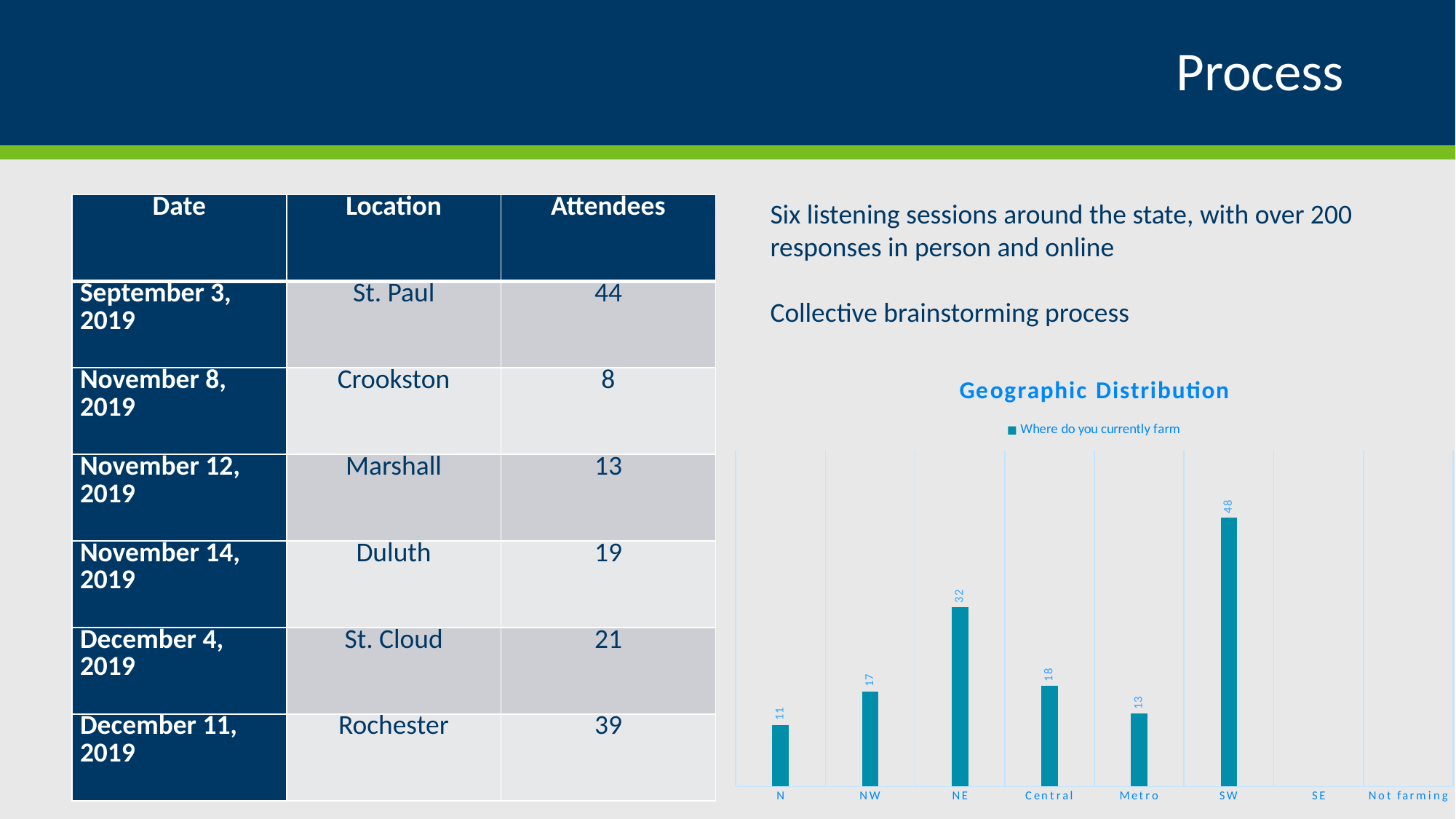
In the Geographic Distribution chart, which region has the highest value? SW What kind of chart is the Geographic Distribution chart? bar chart In the Geographic Distribution chart, what is the value for Metro? 13 What series name does the legend of the Geographic Distribution chart show? Where do you currently farm In the Geographic Distribution chart, what is the value for N? 11 In the Geographic Distribution chart, what is the value for NE? 32 In the Geographic Distribution chart, what is the difference between the values for SW and NE? 16 In the Geographic Distribution chart, what is the difference between the values for NW and N? 6 In the Geographic Distribution chart, what is the value for SW? 48 In the Geographic Distribution chart, what is the value for Central? 18 How many categories are labelled on the x axis of the Geographic Distribution chart? 8 In the Geographic Distribution chart, which is larger, the value for Central or the value for Metro? Central